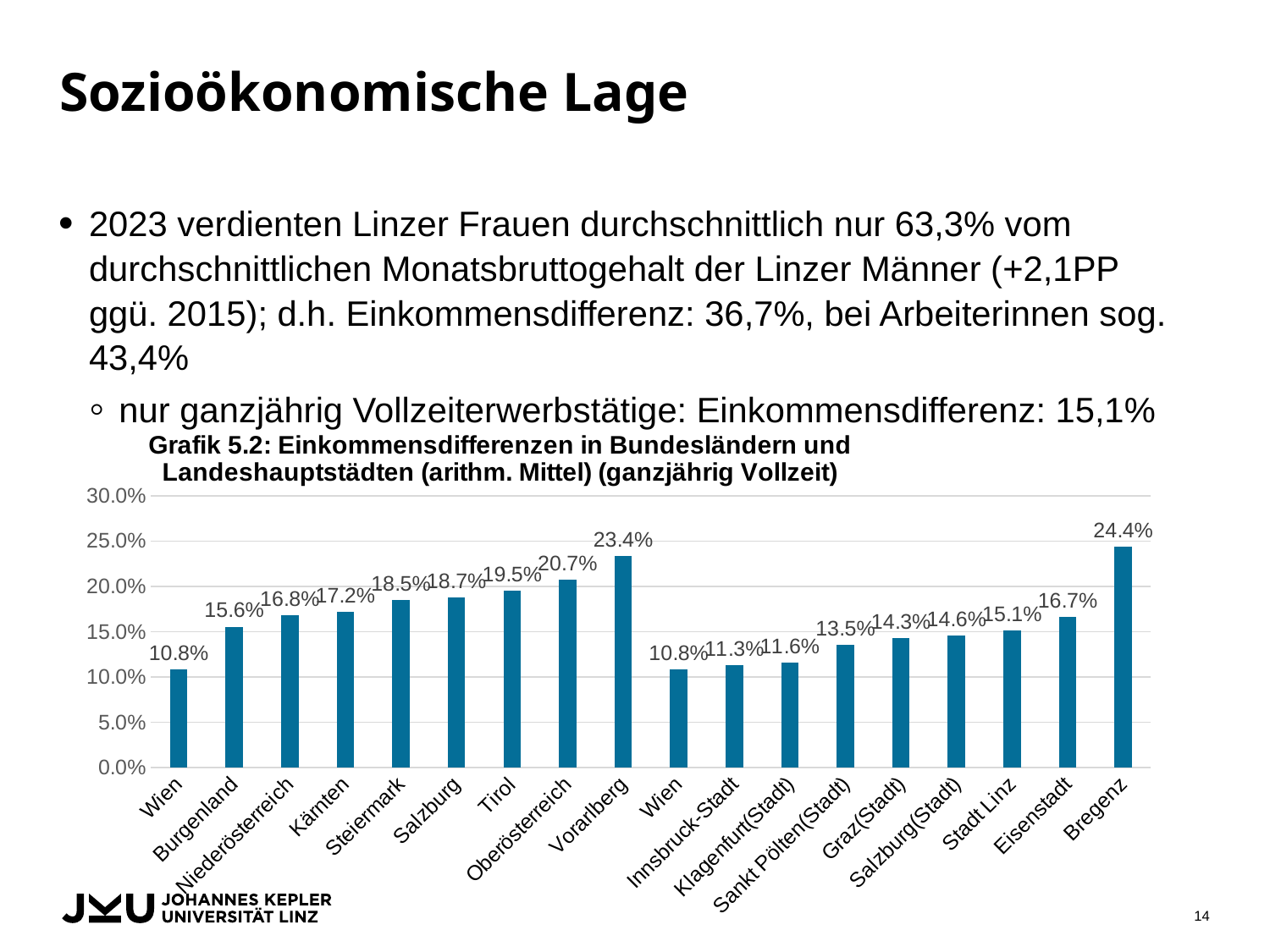
Which category has the highest value in the chart? Bregenz Is the value for Eisenstadt greater or less than 20.0%? less What is the value for Stadt Linz in the chart 'Grafik 5.2: Einkommensdifferenzen in Bundesländern und Landeshauptstädten'? 15.1% What is the value for Vorarlberg in the chart? 23.4% What is the highest value shown in the chart? 24.4% What is the value for Innsbruck-Stadt in the chart? 11.3% Which is larger, the value for Salzburg or the value for Salzburg(Stadt)? Salzburg What is the difference between the values for Bregenz and Stadt Linz? 9.3% What is the value for Oberösterreich in the chart? 20.7% How many bars are shown in the chart? 18 What is the lowest value shown in the chart? 10.8% What kind of chart is shown on the slide? bar chart